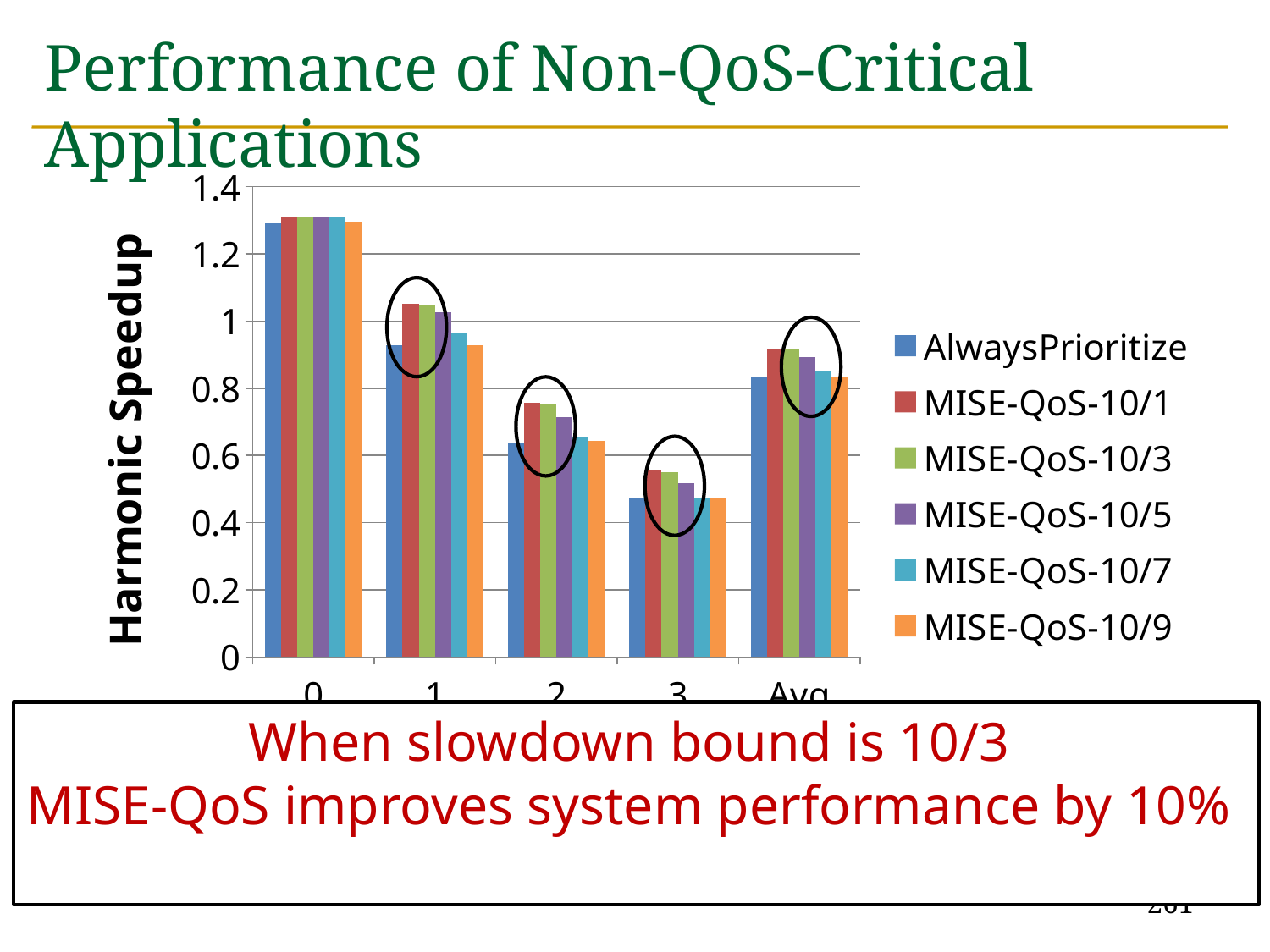
Is the MISE-QoS-10/1 value for category 1 greater or less than 1? greater For category 1, which is larger: MISE-QoS-10/1 or AlwaysPrioritize? MISE-QoS-10/1 What is the label of the y axis? Harmonic Speedup Is the MISE-QoS-10/1 value for category 2 greater or less than 0.8? less Which series is listed first in the legend? AlwaysPrioritize Is the AlwaysPrioritize value for category 3 greater or less than 0.6? less Do the AlwaysPrioritize values rise or fall from category 0 to category 3? fall What kind of chart is shown on the slide? bar chart Which category has the lowest Harmonic Speedup values across all series? 3 How many series does the legend list? 6 How many categories are shown along the x axis? 5